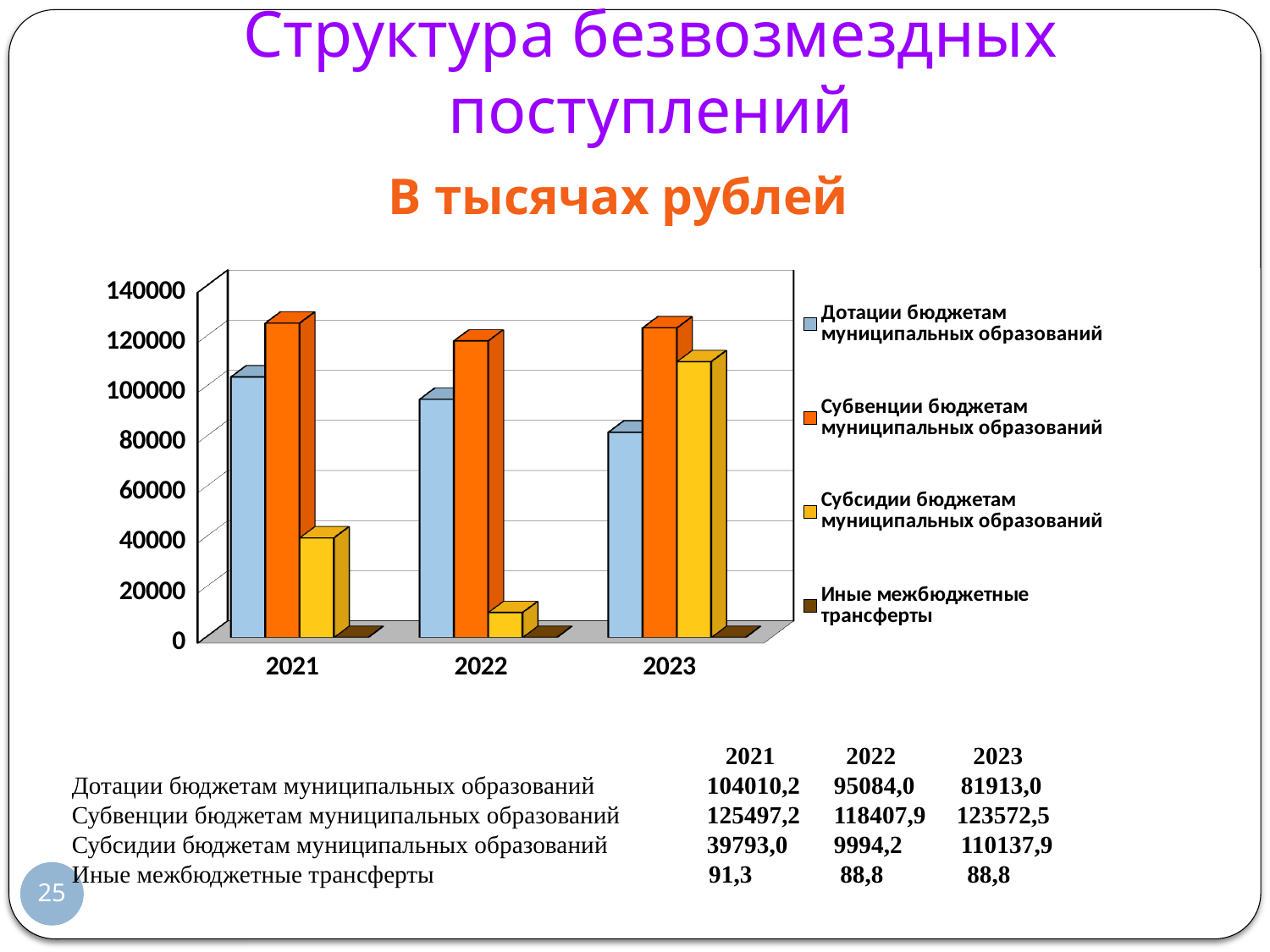
What is the value of Субсидии бюджетам муниципальных образований for 2023? 110137,9 In 2023, which is larger: Субвенции бюджетам муниципальных образований or Субсидии бюджетам муниципальных образований? Субвенции бюджетам муниципальных образований Do the values of Дотации бюджетам муниципальных образований rise or fall from 2021 to 2023? fall What is the difference between the Субвенции бюджетам муниципальных образований values for 2021 and 2022? 7089,3 In which year is the value of Дотации бюджетам муниципальных образований the lowest? 2023 How many years are shown on the x axis of the chart? 3 Is the value for Дотации бюджетам муниципальных образований in 2022 greater or less than 100000? less What colour represents Субвенции бюджетам муниципальных образований in the chart? orange In which year is the value of Субвенции бюджетам муниципальных образований the highest? 2021 How many series does the legend list? 4 What kind of chart is shown on the slide? bar chart What is the value of Дотации бюджетам муниципальных образований for 2021? 104010,2